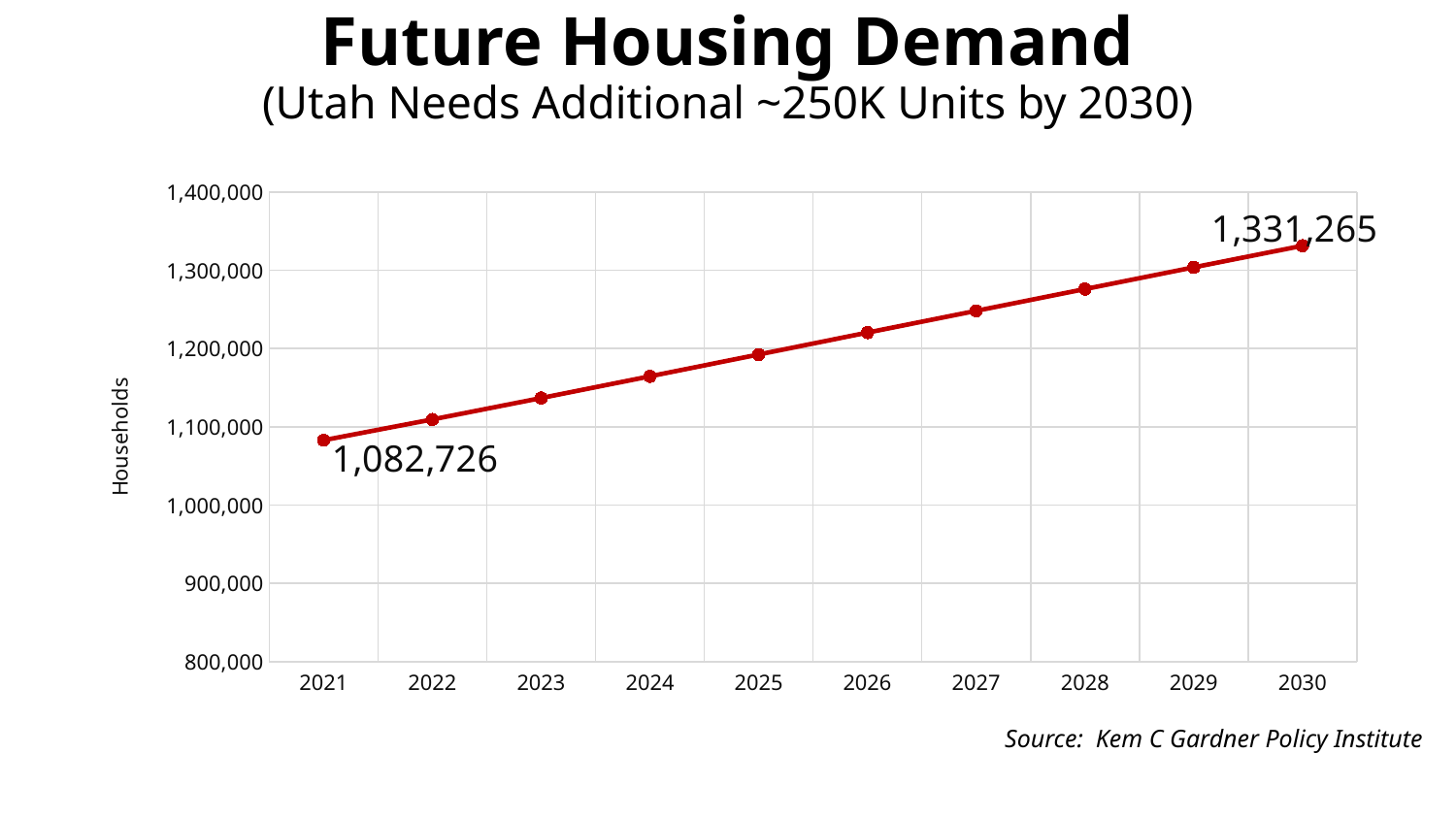
Is the value for 2027 greater or less than 1,200,000? greater How many years are plotted on the x axis? 10 Which year has more households, 2024 or 2028? 2028 Which year has the lowest number of households? 2021 What is the number of households shown for 2021? 1,082,726 What is the number of households shown for 2030? 1,331,265 What kind of chart is shown on the slide? line chart Which year has the highest number of households? 2030 What is the label of the y axis? Households Do the values rise or fall from 2021 to 2030? rise What is the difference between the households in 2030 and in 2021? 248,539